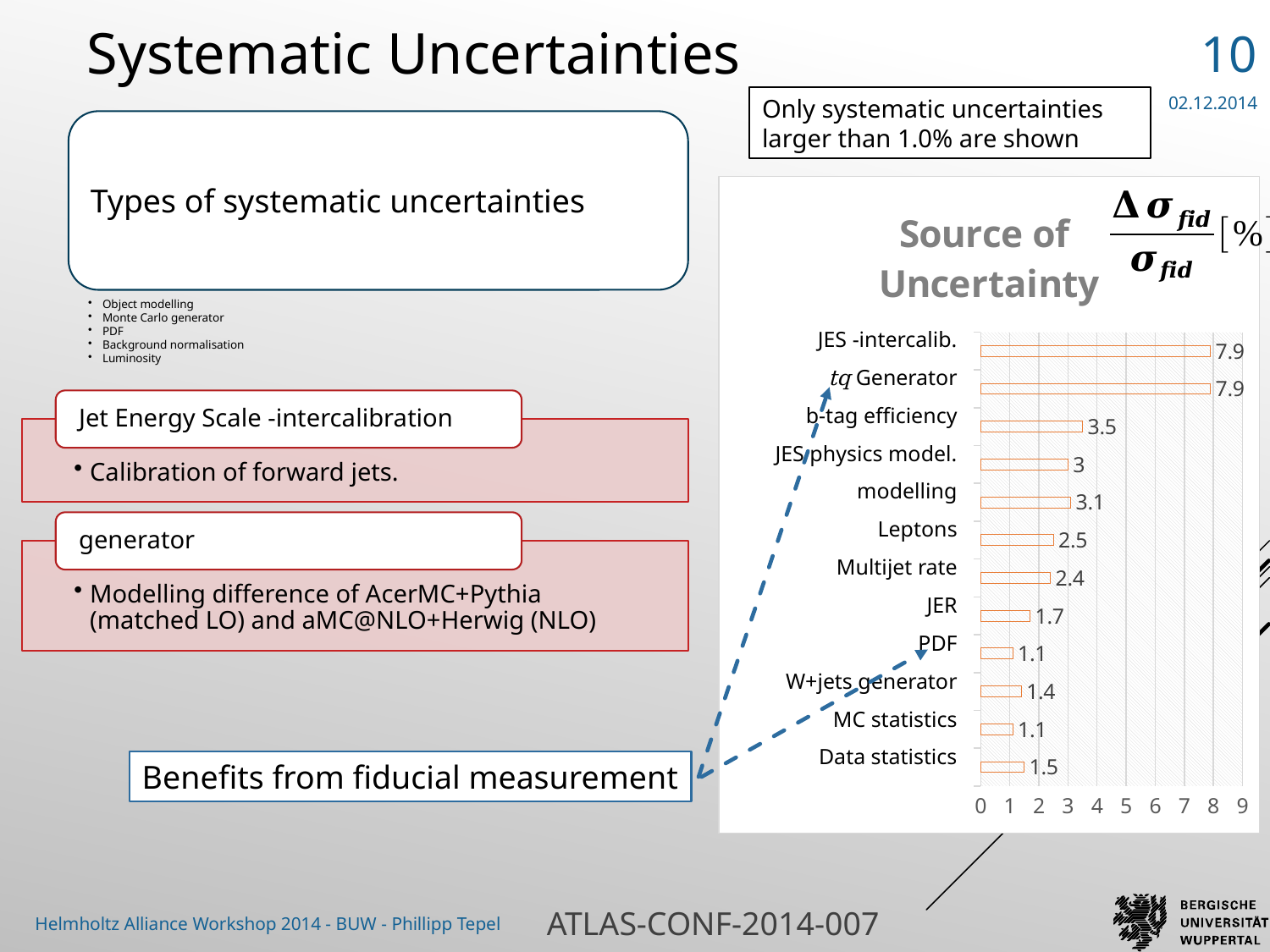
Which is larger, the value for modelling or the value for Leptons? modelling What is the difference between the values for Multijet rate and JER? 0.7 What is the value for Data statistics? 1.5 What kind of chart is shown on the slide? bar chart How many sources of uncertainty are plotted in the chart? 12 What is the value for W+jets generator? 1.4 What is the difference between the values for JES -intercalib. and b-tag efficiency? 4.4 What is the value for b-tag efficiency? 3.5 Is the value for tq Generator greater or less than 5? greater What is the value for Leptons? 2.5 What is the value for JER? 1.7 What is the largest value shown in the chart? 7.9